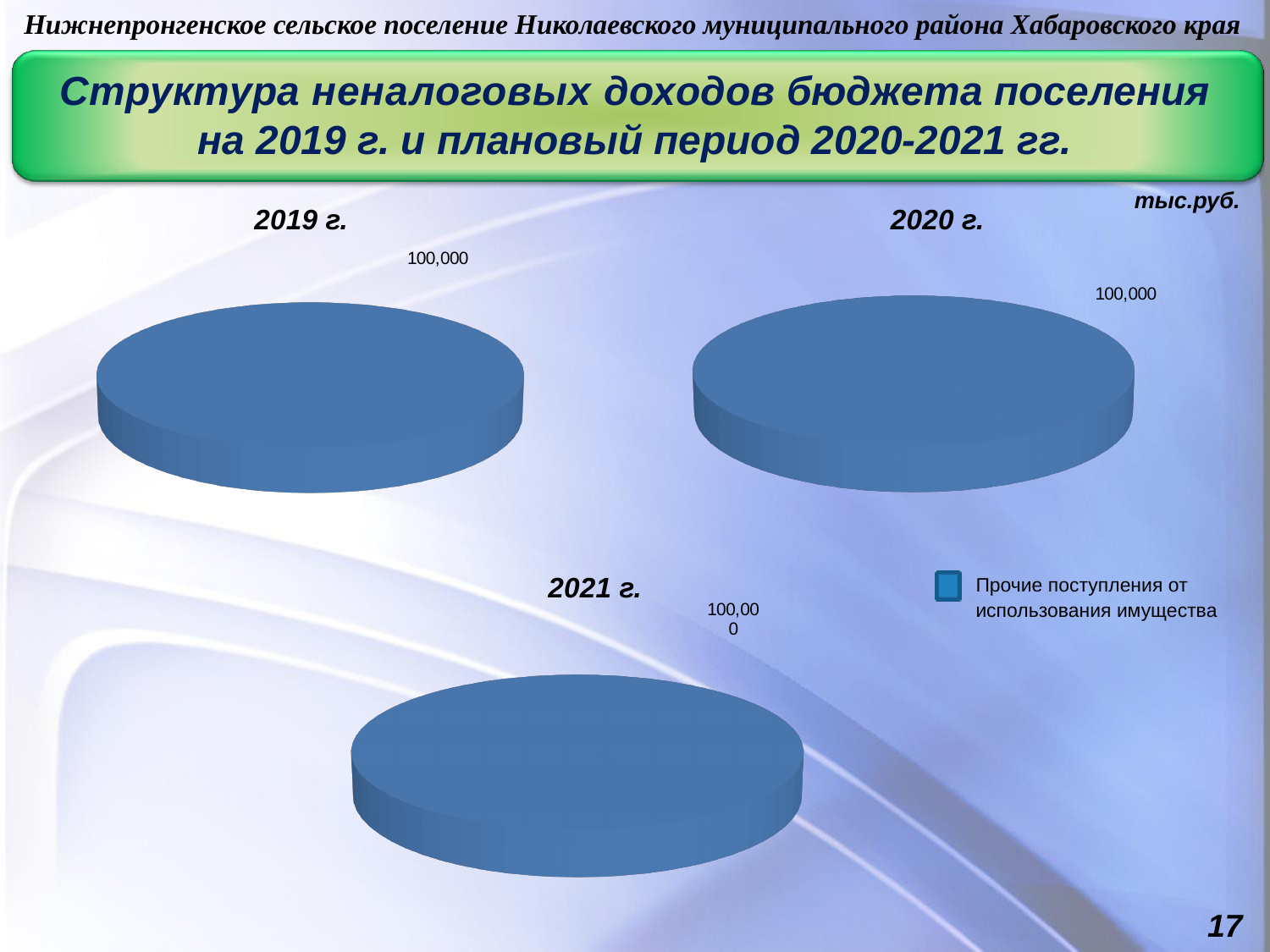
How many slices does the 2021 г. pie chart have? 1 What is the difference between the value in the 2019 г. chart and the value in the 2021 г. chart? 0 How many pie charts are shown on the slide? 3 How many entries does the legend on the slide list? 1 What kind of chart is used for the 2019 г. chart? pie chart What unit is stated for the values on the slide? тыс.руб. In the 2020 г. chart, what share of the pie does the slice for Прочие поступления от использования имущества take? 100% In the 2019 г. chart, what value is printed for the slice? 100,000 In the 2021 г. chart, what value is printed for the slice? 100,000 In the 2020 г. chart, what value is printed for the slice? 100,000 What is the legend entry for the pie charts on the slide? Прочие поступления от использования имущества How many slices does the 2019 г. pie chart have? 1